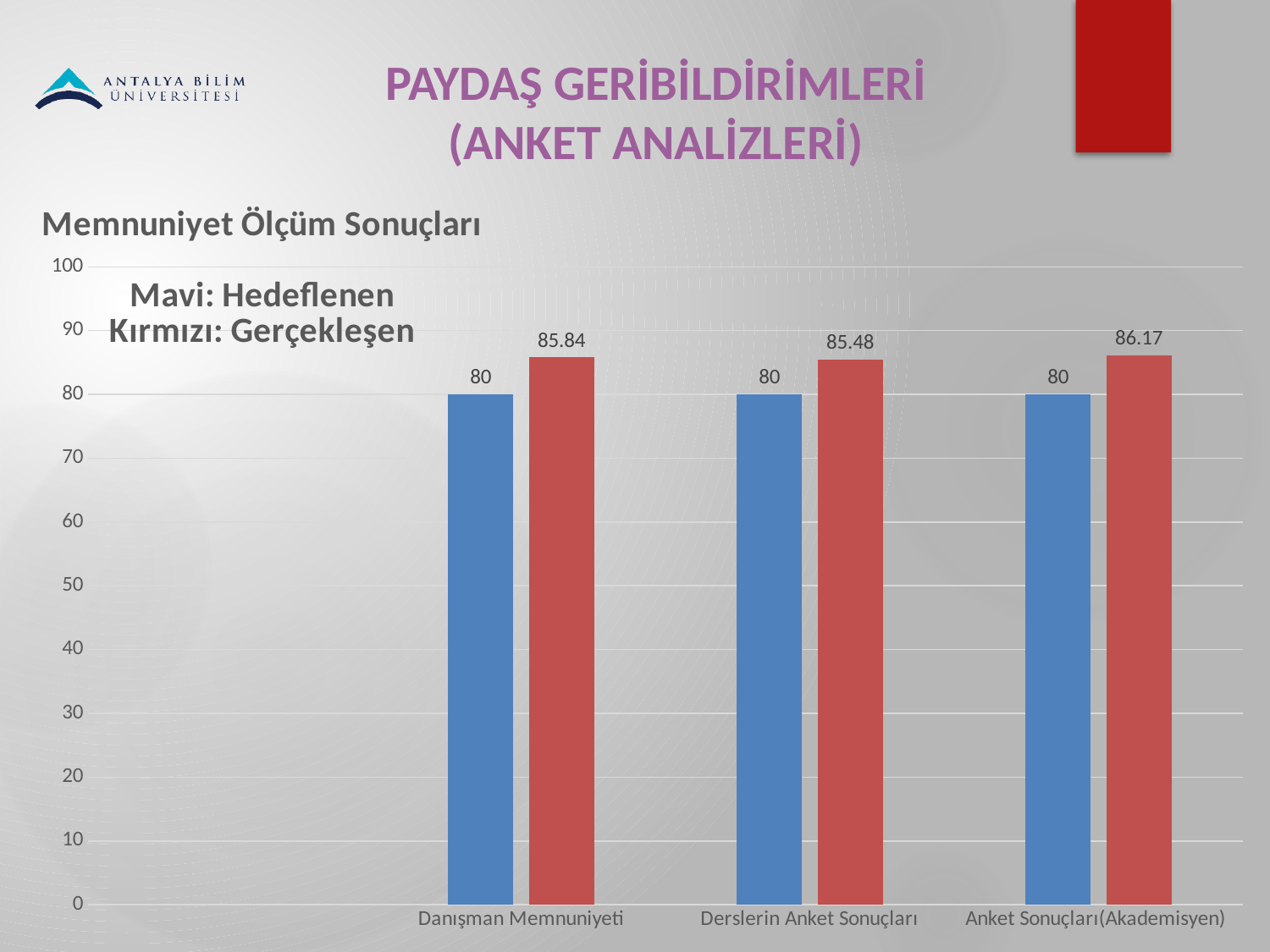
How many categories are shown on the x axis? 3 What is the difference between the Gerçekleşen values for Anket Sonuçları(Akademisyen) and Derslerin Anket Sonuçları? 0.69 Which category has the highest Gerçekleşen (red) value? Anket Sonuçları(Akademisyen) What is the Gerçekleşen (red) value for Derslerin Anket Sonuçları? 85.48 What is the Gerçekleşen (red) value for Anket Sonuçları(Akademisyen)? 86.17 What type of chart is shown on the slide? Bar chart What is the Hedeflenen (blue) value for Derslerin Anket Sonuçları? 80 What is the Gerçekleşen (red) value for Danışman Memnuniyeti? 85.84 For Derslerin Anket Sonuçları, which is larger: the Hedeflenen value or the Gerçekleşen value? Gerçekleşen Which category has the lowest Gerçekleşen (red) value? Derslerin Anket Sonuçları What is the difference between the Gerçekleşen and Hedeflenen values for Danışman Memnuniyeti? 5.84 How many data series are plotted in the chart? 2